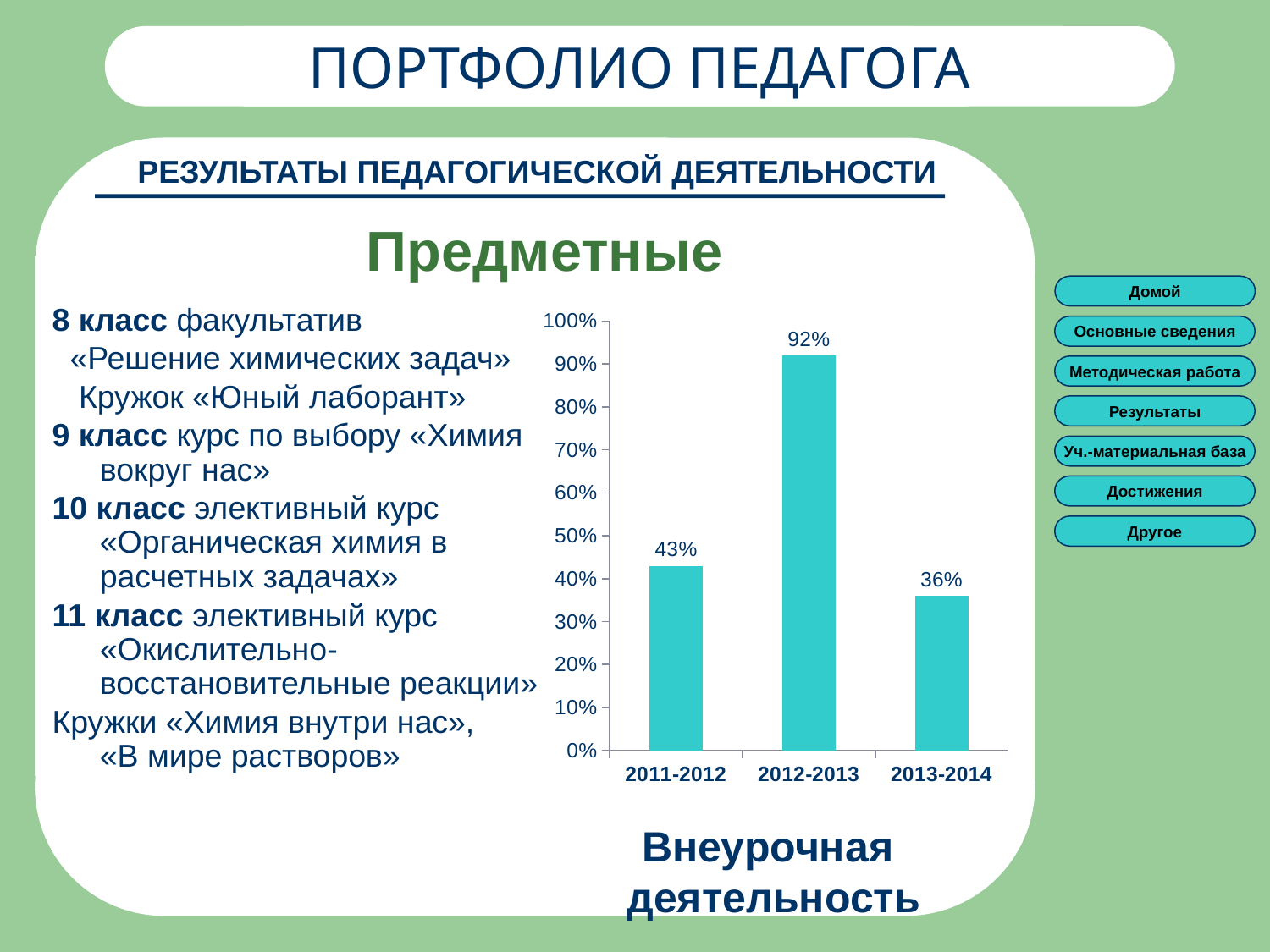
What is the difference between the values for 2011-2012 and 2013-2014? 7% Which is larger, the value for 2011-2012 or the value for 2013-2014? 2011-2012 What kind of chart is shown on the slide? bar chart What is the value for 2012-2013? 92% Which year has the highest value? 2012-2013 What is the maximum value shown on the vertical axis? 100% Is the value for 2012-2013 greater or less than 90%? greater What is the difference between the values for 2012-2013 and 2011-2012? 49% What is the value for 2011-2012? 43% What is the value for 2013-2014? 36% Which year has the lowest value? 2013-2014 How many years are shown on the chart? 3